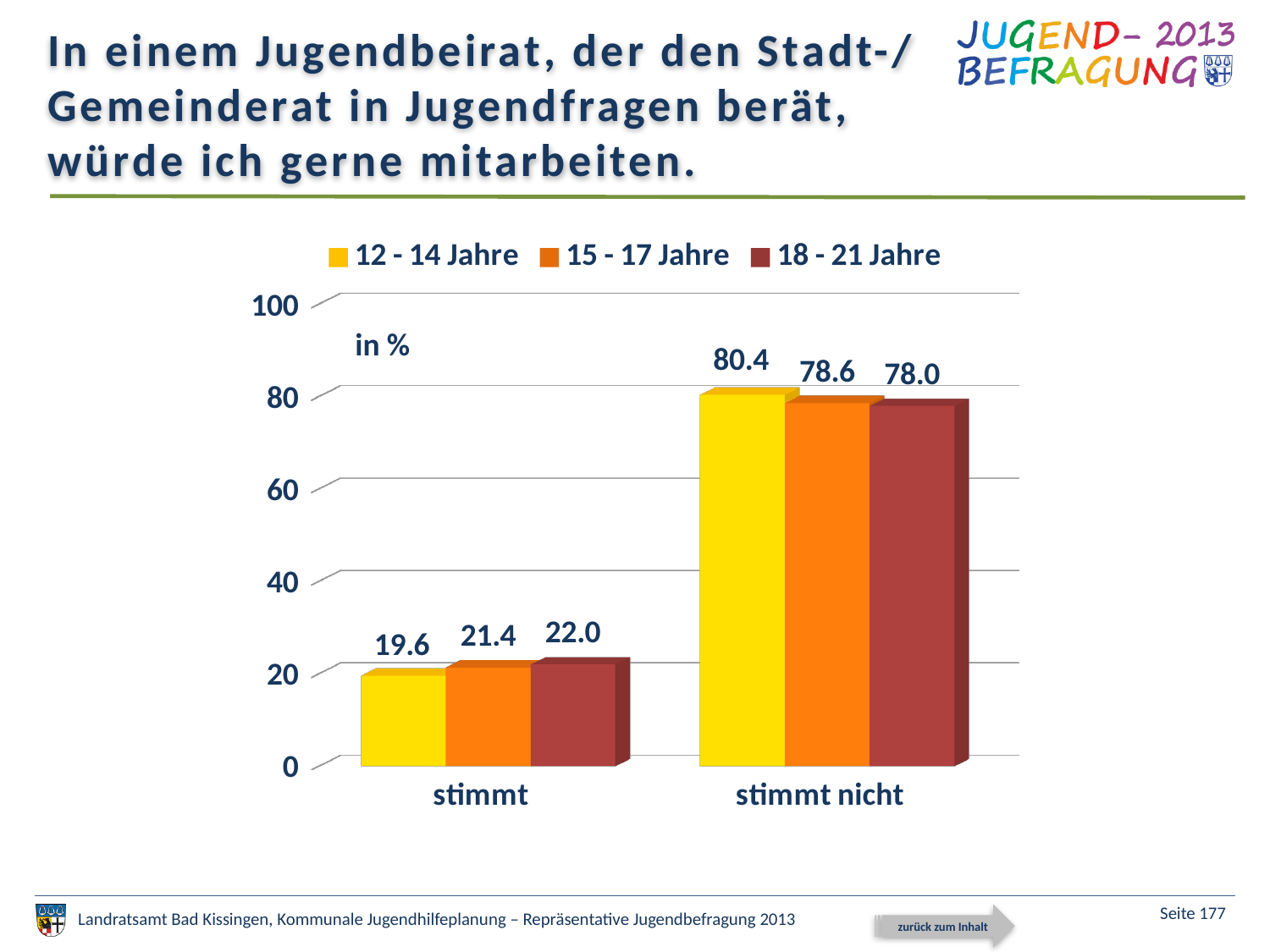
What is the value for the 15 - 17 Jahre series in the 'stimmt' category? 21.4 What is the value for the 18 - 21 Jahre series in the 'stimmt nicht' category? 78.0 Which age group has the highest value in the 'stimmt nicht' category? 12 - 14 Jahre What kind of chart is shown on the slide? bar chart Is the value for 18 - 21 Jahre in the 'stimmt nicht' category greater or less than 60? greater What is the difference between the 18 - 21 Jahre and 12 - 14 Jahre values in the 'stimmt' category? 2.4 How many series does the legend list? 3 What is the difference between the 12 - 14 Jahre values for 'stimmt nicht' and 'stimmt'? 60.8 How many categories are shown on the x axis? 2 Which age group has the lowest value in the 'stimmt' category? 12 - 14 Jahre Which is larger: the 15 - 17 Jahre value for 'stimmt' or for 'stimmt nicht'? stimmt nicht What is the value for the 12 - 14 Jahre series in the 'stimmt' category? 19.6